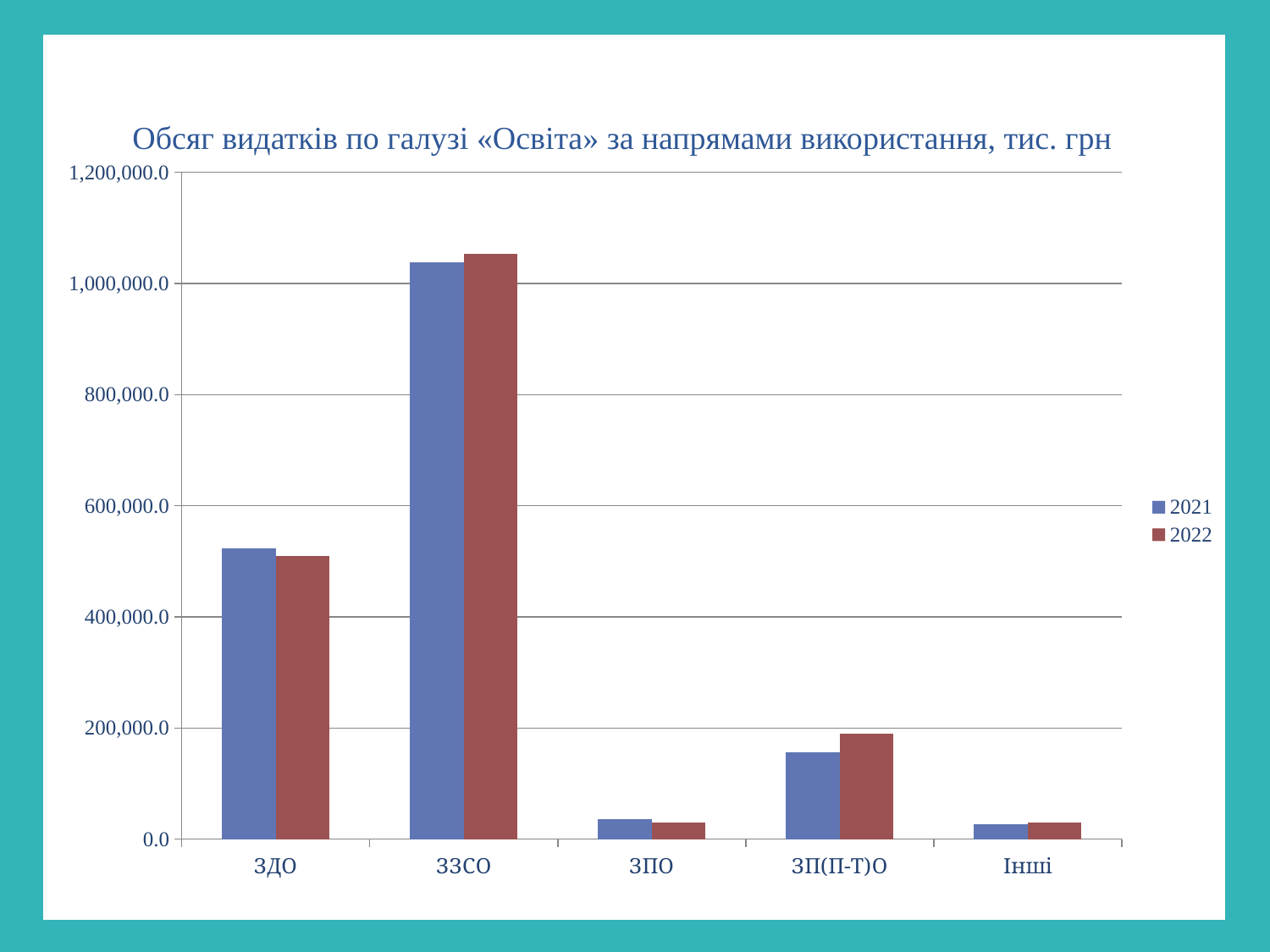
Is the value for ЗЗСО in 2022 greater or less than 1,000,000.0? greater What is the title of the chart? Обсяг видатків по галузі «Освіта» за напрямами використання, тис. грн For ЗП(П-Т)О, which year has the larger value, 2021 or 2022? 2022 How many series does the legend list? 2 Which category has the highest value for 2021? ЗЗСО Is the value for ЗДО in 2021 greater or less than 400,000.0? greater Which is larger: the 2021 value for ЗДО or the 2021 value for ЗП(П-Т)О? ЗДО How many categories are shown on the x axis? 5 Is the value for ЗП(П-Т)О in 2022 greater or less than 200,000.0? less Which category has the highest value for 2022? ЗЗСО What kind of chart is shown on the slide? bar chart